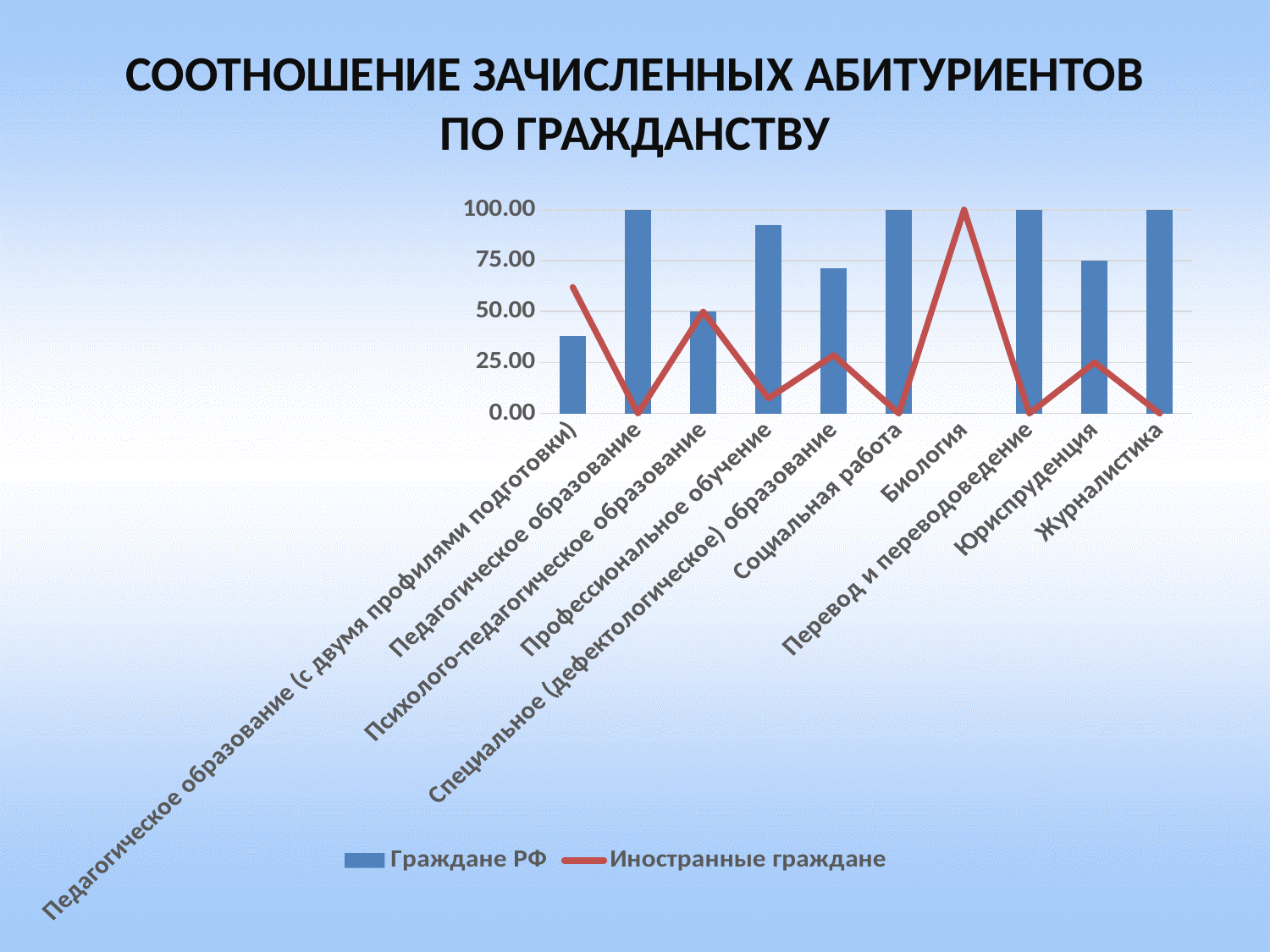
Is the value of Иностранные граждане for Педагогическое образование (с двумя профилями подготовки) greater or less than 50.00? greater How many series does the legend list? 2 What is the value of Граждане РФ for Юриспруденция? 75.00 Is the value of Граждане РФ for Педагогическое образование (с двумя профилями подготовки) greater or less than 50.00? less What is the value of Иностранные граждане for Биология? 100.00 Is the value of Граждане РФ for Профессиональное обучение greater or less than 75.00? greater How many categories are shown on the x axis? 10 What is the value of Граждане РФ for Журналистика? 100.00 For Граждане РФ, which is larger: Специальное (дефектологическое) образование or Профессиональное обучение? Профессиональное обучение Which two series are listed in the legend? Граждане РФ and Иностранные граждане What kind of chart is shown on the slide? A combined bar and line chart For Биология, which series has the larger value: Граждане РФ or Иностранные граждане? Иностранные граждане